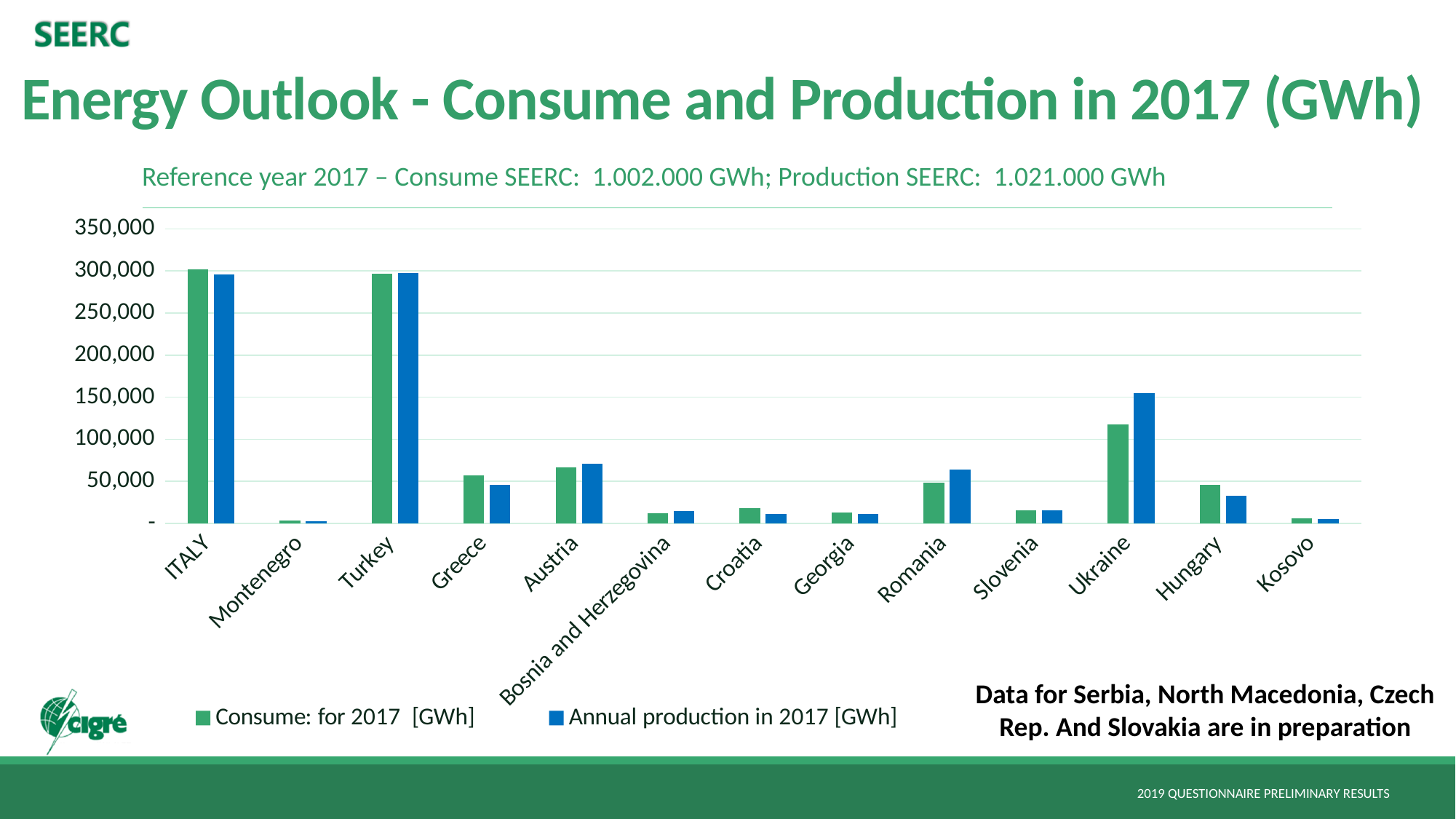
Is the Annual production value for Austria greater or less than 50,000? greater Is the Consume value for ITALY greater or less than 250,000? greater Is the Annual production value for Hungary greater or less than 50,000? less For Romania, which is larger: Consume or Annual production in 2017? Annual production in 2017 What kind of chart is shown on the slide? bar chart Which series is shown in green in the chart? Consume: for 2017 [GWh] For Greece, which is larger: Consume or Annual production in 2017? Consume What is the title of the slide containing the chart? Energy Outlook - Consume and Production in 2017 (GWh) How many series does the chart legend list? 2 For Ukraine, which is larger: Consume or Annual production in 2017? Annual production in 2017 How many countries are shown on the x axis of the chart? 13